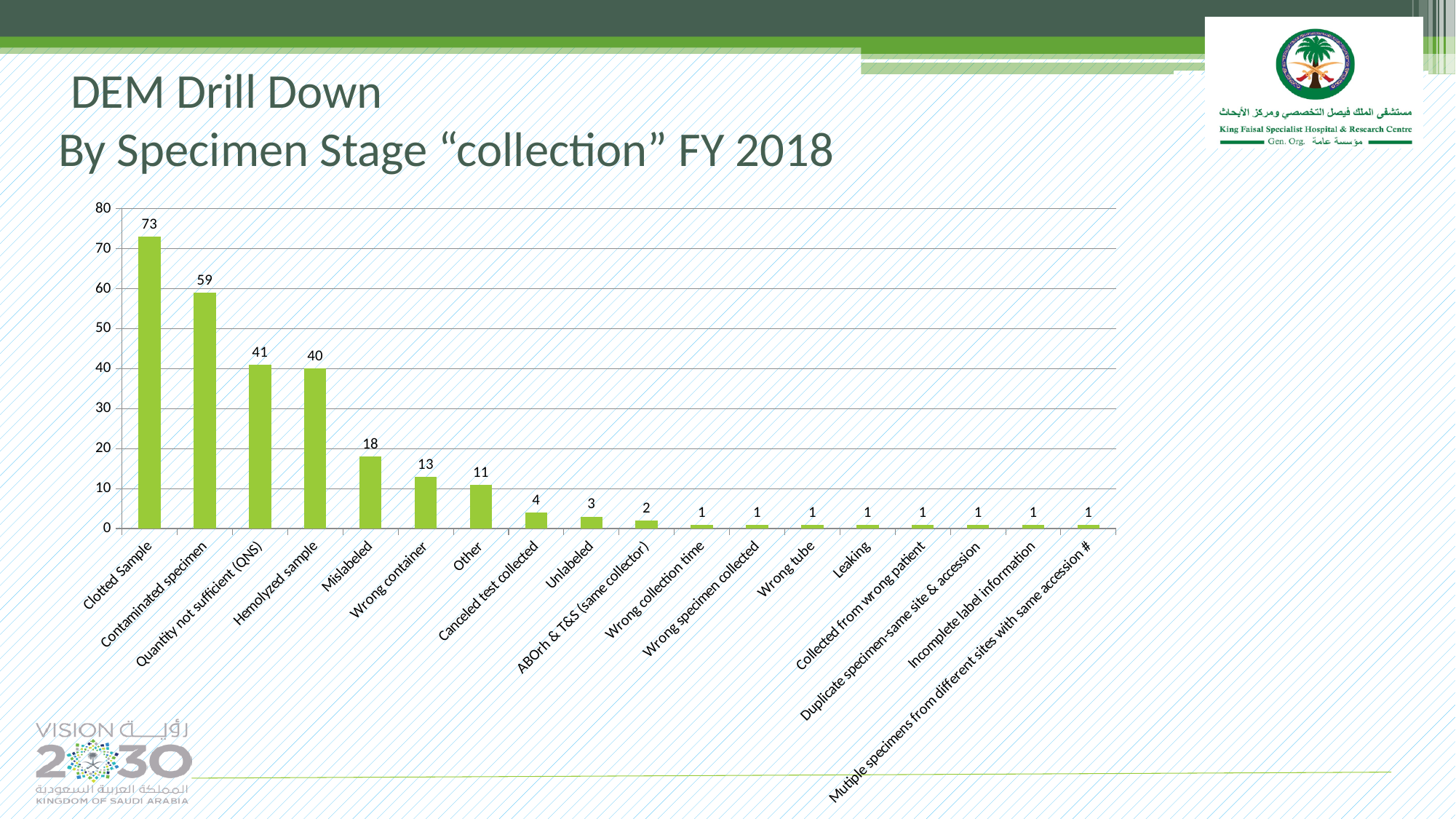
Which is larger, Quantity not sufficient (QNS) or Hemolyzed sample? Quantity not sufficient (QNS) What is the value for Unlabeled? 3 How many categories are shown on the x axis? 18 What is the value for Hemolyzed sample? 40 What kind of chart is shown on the slide? bar chart What is the value for Clotted Sample? 73 What is the difference between Clotted Sample and Contaminated specimen? 14 Do the values rise or fall from left to right along the x axis? fall Which category has the highest value? Clotted Sample What is the difference between Mislabeled and Other? 7 Is the value for Contaminated specimen greater or less than 50? greater What is the value for Wrong container? 13